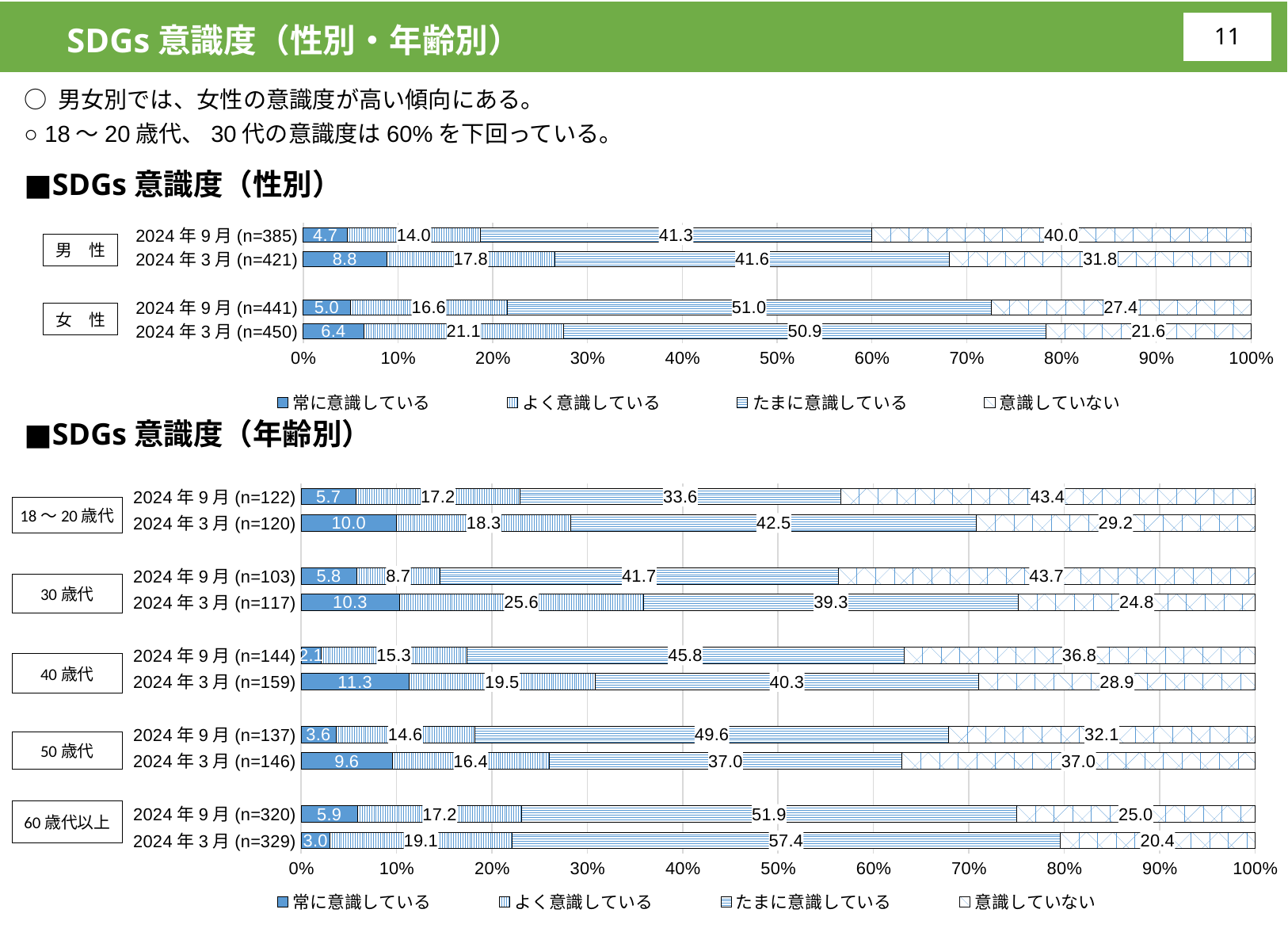
What type of chart is the SDGs 意識度（年齢別） chart? Stacked bar chart In the SDGs 意識度（年齢別） chart, which bar has the lowest value for 常に意識している? 40歳代 2024年9月 (n=144) In the SDGs 意識度（性別） chart, what is the value of 意識していない for 男性 2024年9月 (n=385)? 40.0 In the SDGs 意識度（年齢別） chart, what is the value of よく意識している for 30歳代 2024年9月 (n=103)? 8.7 In the SDGs 意識度（性別） chart, what is the value of たまに意識している for 女性 2024年9月 (n=441)? 51.0 In the SDGs 意識度（年齢別） chart, which bar has the highest value for 意識していない? 30歳代 2024年9月 (n=103) In the SDGs 意識度（性別） chart, how many series does the legend list? 4 In the SDGs 意識度（年齢別） chart, which is larger: the 常に意識している value for 18〜20歳代 2024年3月 (n=120) or for 50歳代 2024年3月 (n=146)? 18〜20歳代 2024年3月 (n=120) In the SDGs 意識度（性別） chart, what is the difference between the 意識していない values for 男性 2024年9月 (n=385) and 女性 2024年9月 (n=441)? 12.6 In the SDGs 意識度（年齢別） chart, how many bars are plotted? 10 In the SDGs 意識度（年齢別） chart, what is the value of たまに意識している for 60歳代以上 2024年3月 (n=329)? 57.4 In the SDGs 意識度（性別） chart, which bar has the highest value for 常に意識している? 男性 2024年3月 (n=421)